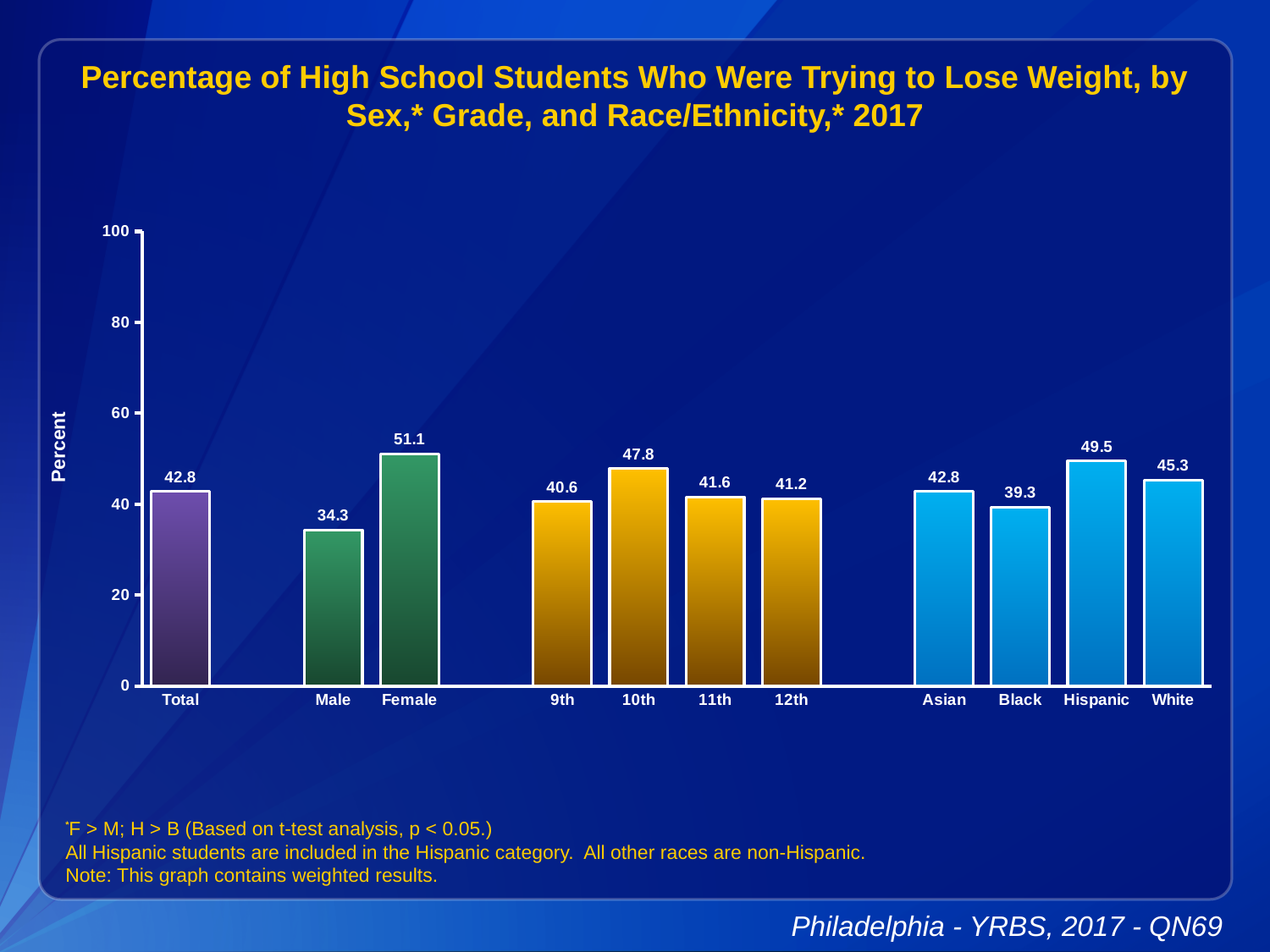
What is the value for Female students? 51.1 Is the value for White students greater or less than 40? greater Which category has the lowest value on the chart? Male What is the label on the vertical axis? Percent What is the value for 10th grade students? 47.8 What percentage of students in the Total category were trying to lose weight? 42.8 What is the difference between the Female and Male values? 16.8 Which is larger, the value for Hispanic students or the value for Black students? Hispanic What kind of chart is shown on the slide? Bar chart Which category has the highest value on the chart? Female What is the value for Hispanic students? 49.5 How many bars are shown on the chart? 11